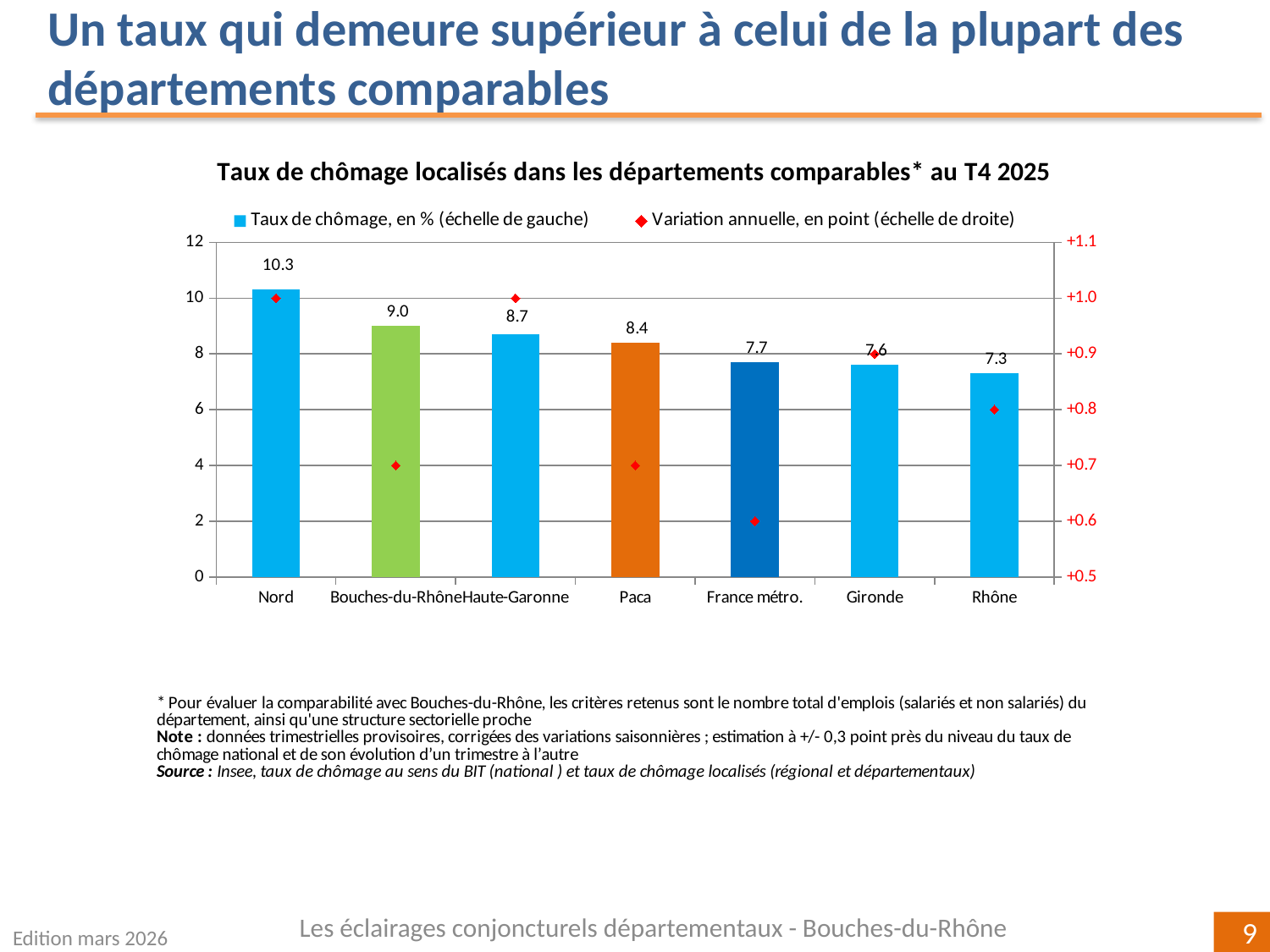
Which department has the highest unemployment rate on the chart? Nord What is the unemployment rate shown for Nord? 10.3 How many series does the legend list? 2 What is the unemployment rate (Taux de chômage) shown for Bouches-du-Rhône? 9.0 Which category has the lowest unemployment rate on the chart? Rhône What is the title of the chart? Taux de chômage localisés dans les départements comparables* au T4 2025 What is the unemployment rate shown for France métro.? 7.7 What is the annual variation shown for France métro., on the right-hand scale? +0.6 What is the annual variation (Variation annuelle) shown for Nord, on the right-hand scale? +1.0 How many categories (departments/areas) are shown on the x axis? 7 What is the difference between the unemployment rate of Bouches-du-Rhône and that of France métro.? 1.3 Which has a higher unemployment rate, Haute-Garonne or Paca? Haute-Garonne